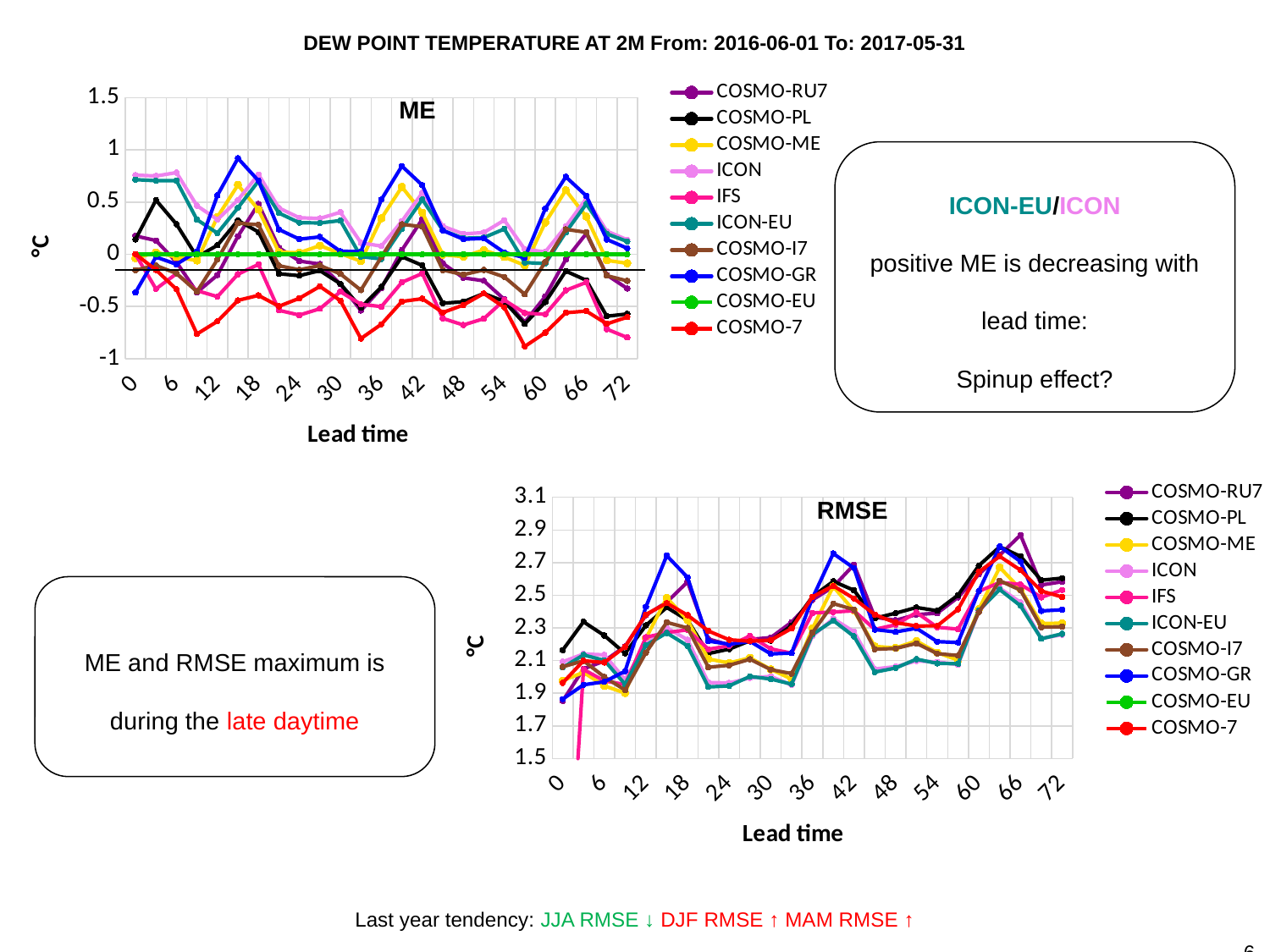
How many series does the legend of the RMSE chart list? 10 What kind of chart is the ME chart? line chart How many lead time tick labels are shown on the x axis of the ME chart? 13 In the RMSE chart, is the value for ICON-EU at lead time 24 greater or less than 2.1? less What is the x-axis label of the RMSE chart? Lead time In the ME chart, is the value for COSMO-GR at lead time 15 greater or less than 0.5? greater In the RMSE chart, is the value for COSMO-GR at lead time 15 greater or less than 2.5? greater How many series does the legend of the ME chart list? 10 In the ME chart, which series has the lowest value at lead time 0? COSMO-GR What is the y-axis label of the ME chart? °C